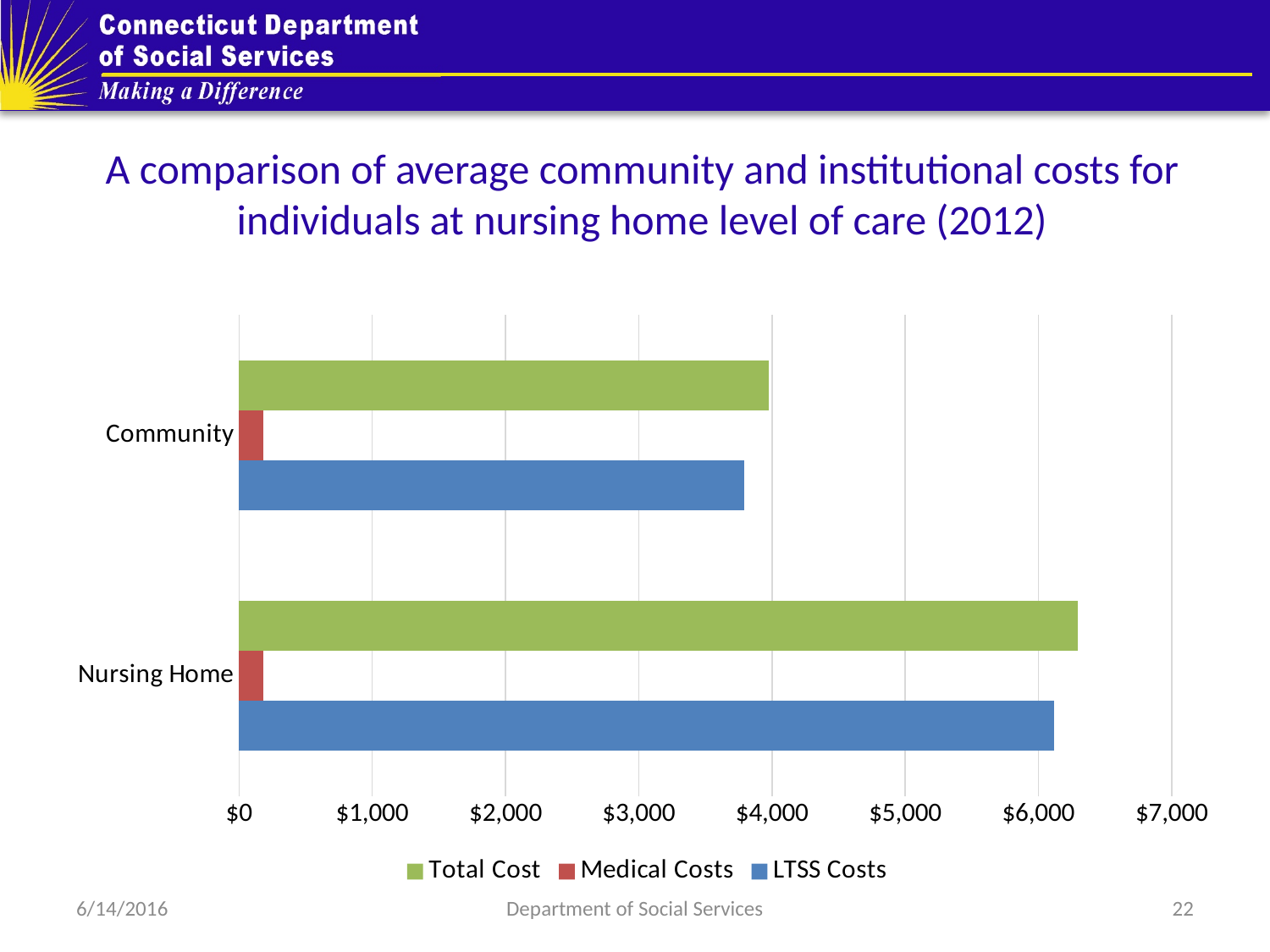
Is the Total Cost for Nursing Home greater or less than $6,000? greater How many series does the legend list? 3 How many categories are shown on the vertical axis? 2 Which category has the higher Total Cost, Community or Nursing Home? Nursing Home Is the LTSS Costs value for Community greater or less than $4,000? less Which series is shown in green in the legend? Total Cost Which series has the highest value for Community? Total Cost Which series has the lowest value for Nursing Home? Medical Costs Is the Medical Costs value for Nursing Home greater or less than $1,000? less What kind of chart is shown on the slide? bar chart